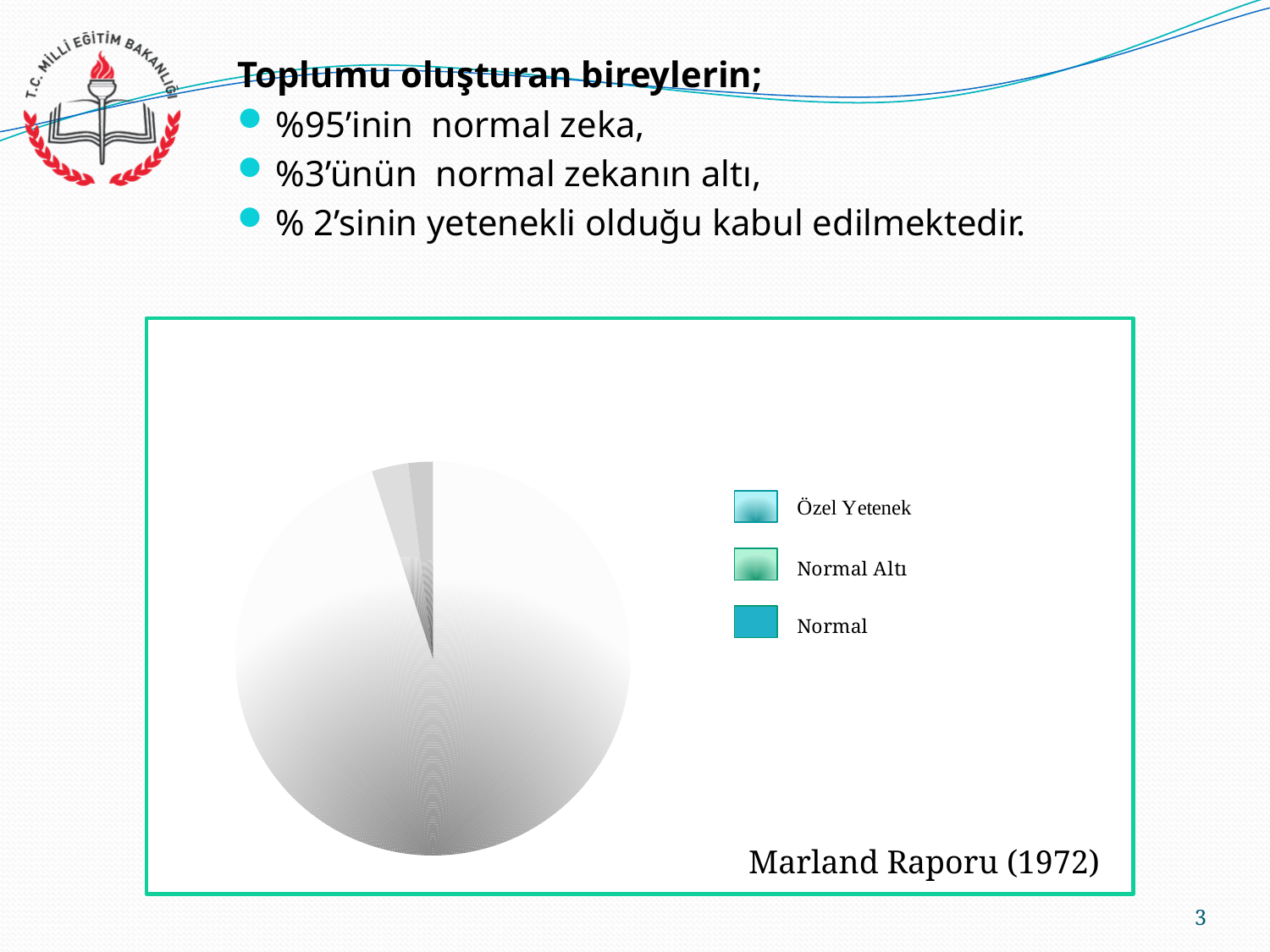
Which entry is listed first in the legend of the pie chart? Özel Yetenek Which slice is larger in the pie chart, Normal or Normal Altı? Normal Which category has the largest slice in the pie chart? Normal What kind of chart is shown on the slide? pie chart How many entries does the legend of the pie chart list? 3 How many slices does the pie chart have? 3 What source is cited in the bottom right corner of the chart box? Marland Raporu (1972) Which slice is larger in the pie chart, Normal or Özel Yetenek? Normal